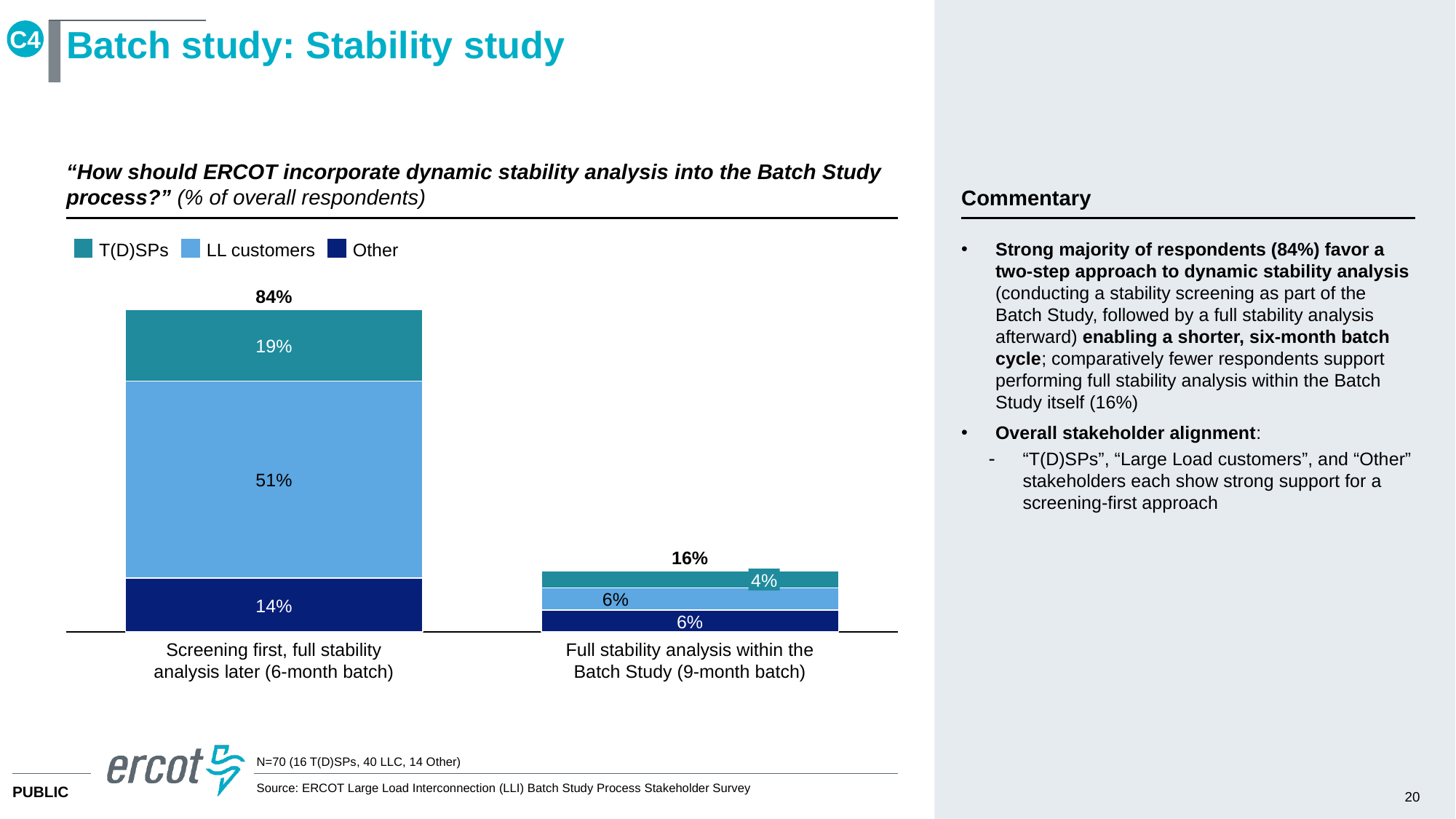
Which is larger: the LL customers value for "Screening first" or the LL customers value for "Full stability analysis within the Batch Study"? Screening first, full stability analysis later (6-month batch) Which legend entry is shown in the darkest blue colour? Other What is the difference between the T(D)SPs values for the two categories? 15% What is the T(D)SPs value for "Full stability analysis within the Batch Study (9-month batch)"? 4% How many series does the legend list? 3 How many categories are shown on the x axis? 2 What is the total for the "Screening first, full stability analysis later (6-month batch)" bar? 84% What kind of chart is shown on the slide? Stacked bar chart What is the LL customers value for "Screening first, full stability analysis later (6-month batch)"? 51% What is the total for the "Full stability analysis within the Batch Study (9-month batch)" bar? 16% What is the Other value for "Screening first, full stability analysis later (6-month batch)"? 14% Which category has the highest total? Screening first, full stability analysis later (6-month batch)